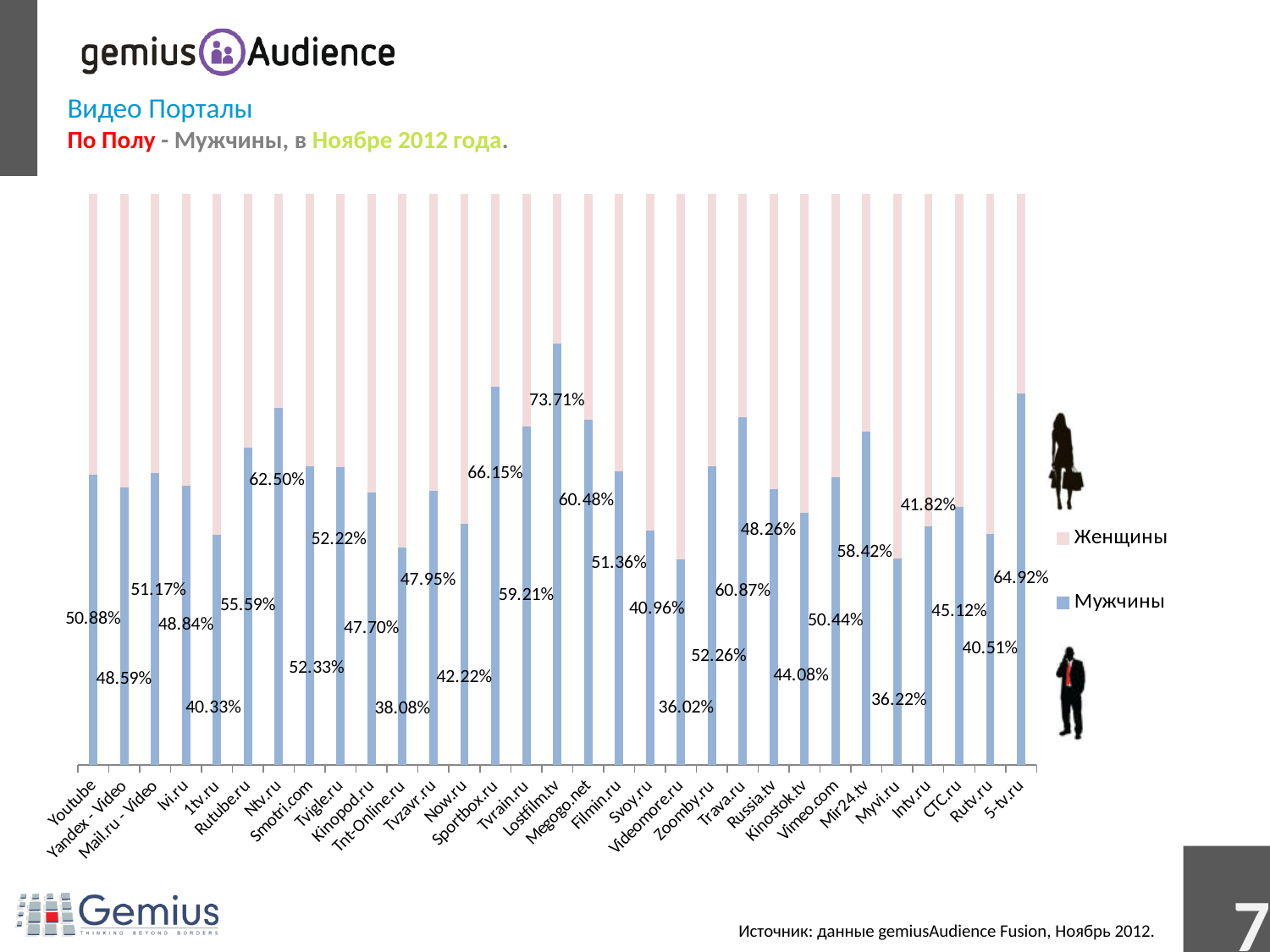
What are the two series named in the legend? Женщины and Мужчины Which has a larger share of men: Trava.ru or Kinostok.tv? Trava.ru What is the share of men (Мужчины) for 5-tv.ru? 64.92% How many series does the legend list? 2 What kind of chart is shown on the slide? Bar chart What is the difference between the men's share for Lostfilm.tv and for Sportbox.ru? 7.56% What is the share of men (Мужчины) for Youtube? 50.88% Which video portal has the highest share of men (Мужчины)? Lostfilm.tv How many video portals are shown on the x axis of the chart? 31 What is the share of men (Мужчины) for Lostfilm.tv? 73.71% What is the share of men (Мужчины) for Sportbox.ru? 66.15% Which has a larger share of men: Ntv.ru or Rutube.ru? Ntv.ru